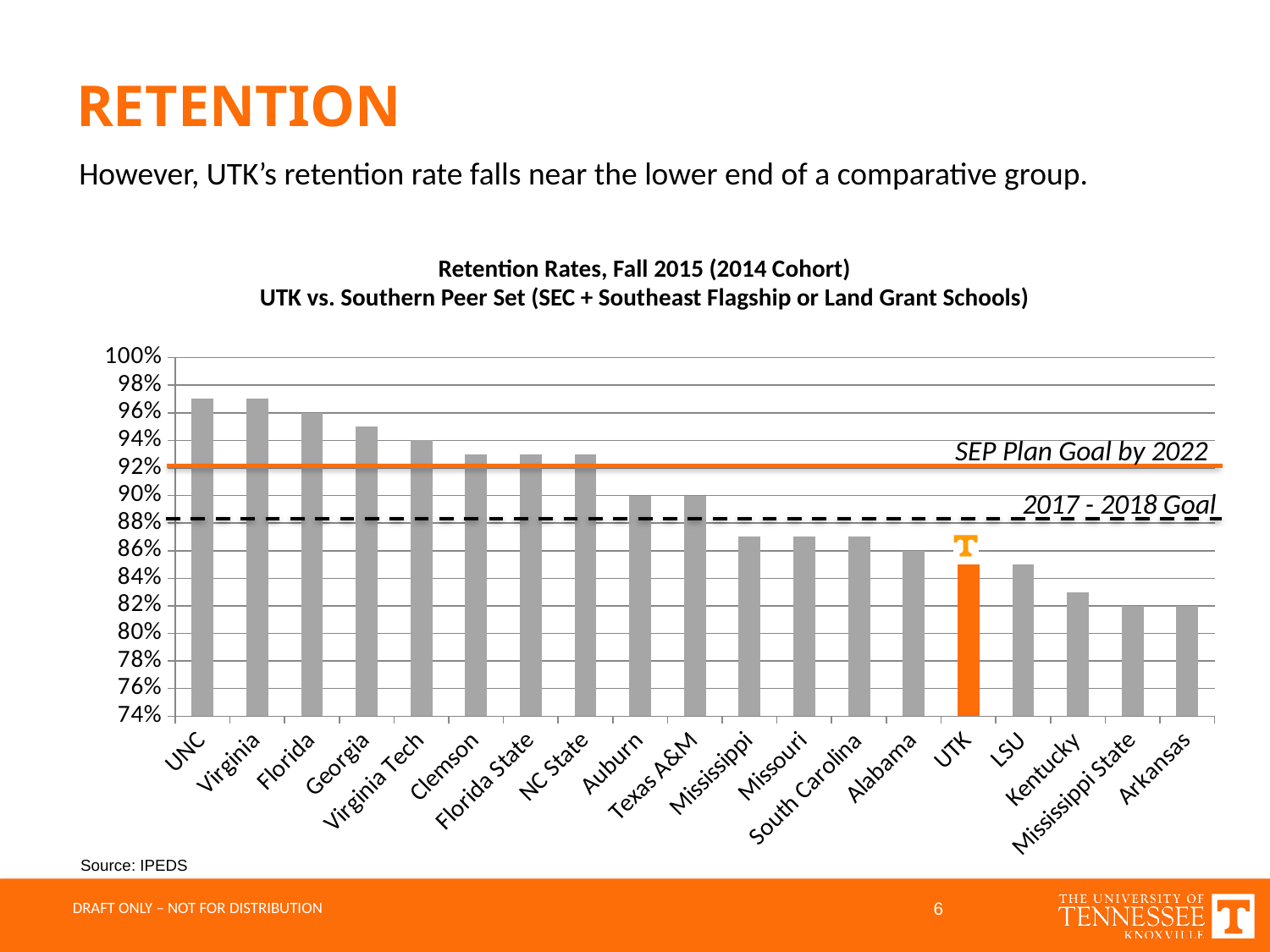
Do the retention rates rise or fall moving from left to right along the x axis? Fall Is the retention rate for UTK greater or less than 88%? less Is the retention rate for Florida greater or less than 94%? greater Which school's bar is coloured orange instead of grey? UTK Which has the higher retention rate, Alabama or Georgia? Georgia Is the retention rate for Kentucky greater or less than 80%? greater How many schools are shown on the x axis of the chart? 19 What is the label on the solid orange horizontal line in the chart? SEP Plan Goal by 2022 What kind of chart is shown on the slide? Bar chart Which has the higher retention rate, UNC or Arkansas? UNC